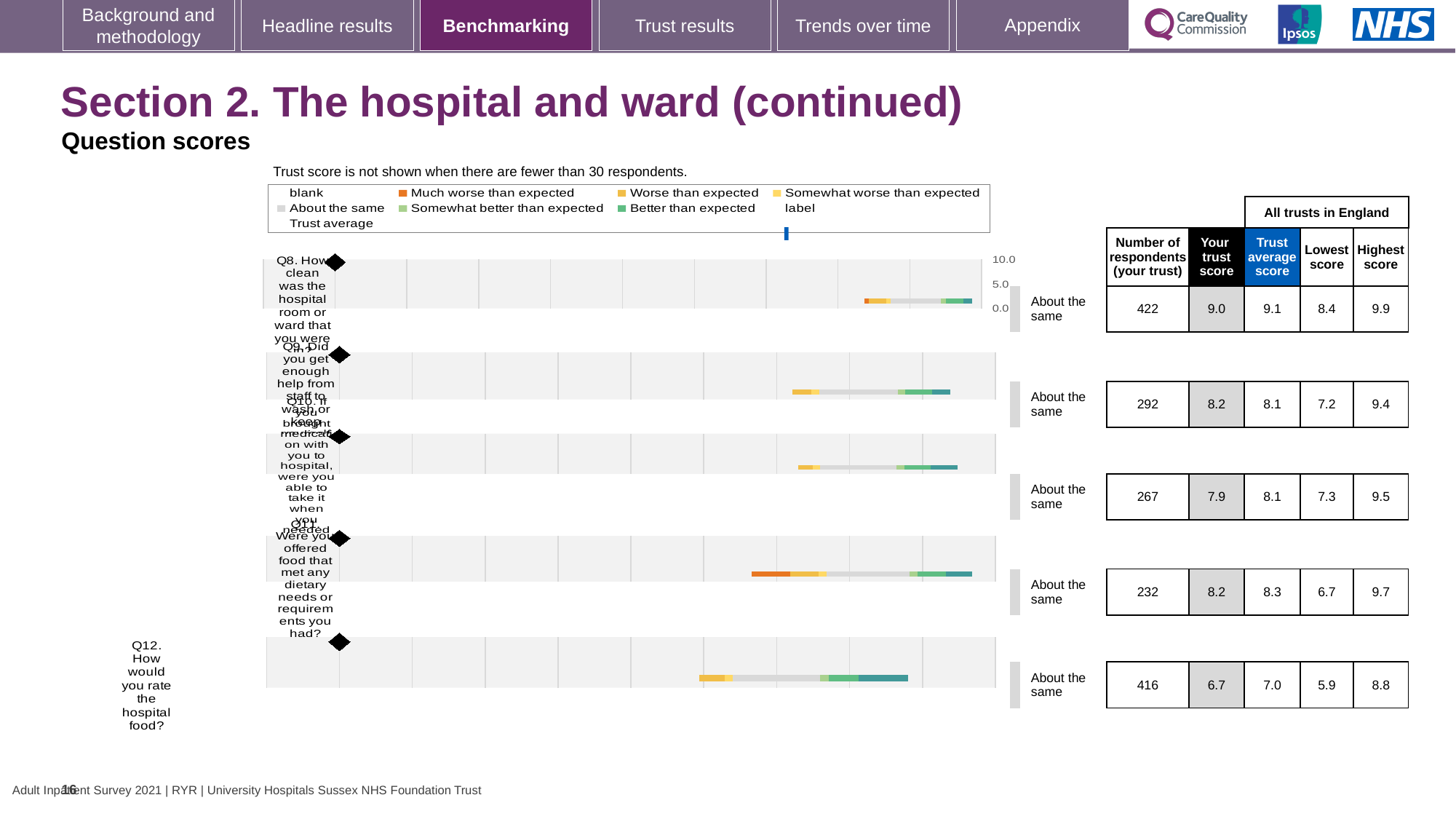
How many respondents answered Q12 (How would you rate the hospital food)? 416 What is the trust score for Q8 (How clean was the hospital room or ward that you were in)? 9.0 What is the highest score across all trusts in England for Q8? 9.9 What kind of chart is used to show the question scores? Bar chart Which question has the lowest trust score? Q12 Which question has the highest trust score? Q8 What is the benchmark category shown for Q10? About the same Is the trust score for Q12 greater or less than 5.0? greater What is the difference between the highest and lowest scores in England for Q12? 2.9 What is the difference between the trust average score and the trust score for Q8? 0.1 For Q9, which is larger: the trust score or the trust average score? The trust score (8.2) How many questions are shown in the chart? 5